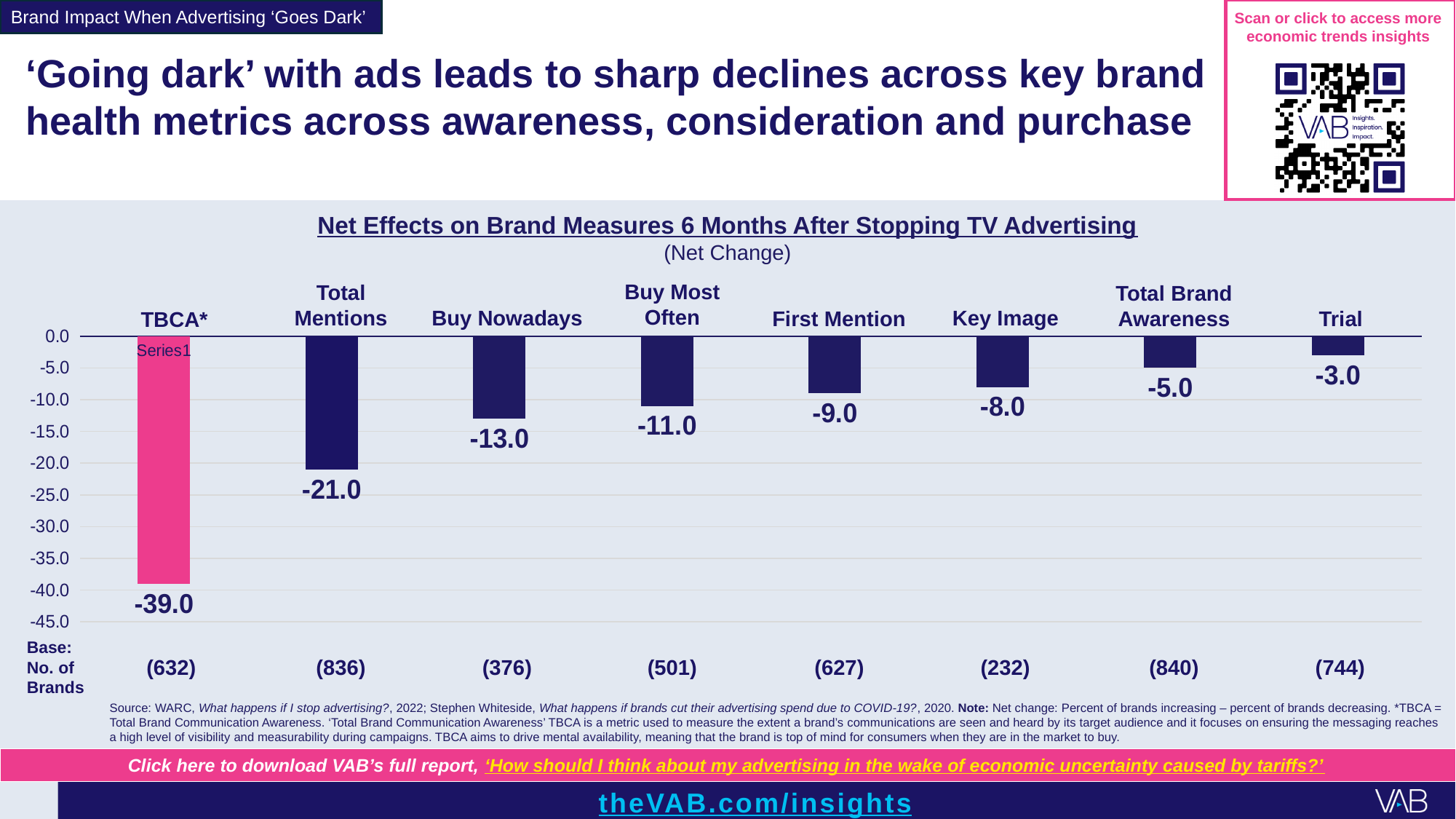
Which brand measure shows the largest decline (lowest value)? TBCA* How many brand measures are plotted in the chart? 8 Which brand measure shows the smallest decline (highest value)? Trial What type of chart is shown on the slide? Bar chart What is the net change value for Total Mentions? -21.0 What is the difference between the values for Buy Nowadays and Buy Most Often? 2.0 What is the net change value for Key Image? -8.0 Do the values rise or fall moving from left to right across the categories? Rise What colour is the bar for TBCA*? Pink Which has a larger decline, First Mention or Total Brand Awareness? First Mention What is the net change value for TBCA*? -39.0 What is the net change value for Trial? -3.0